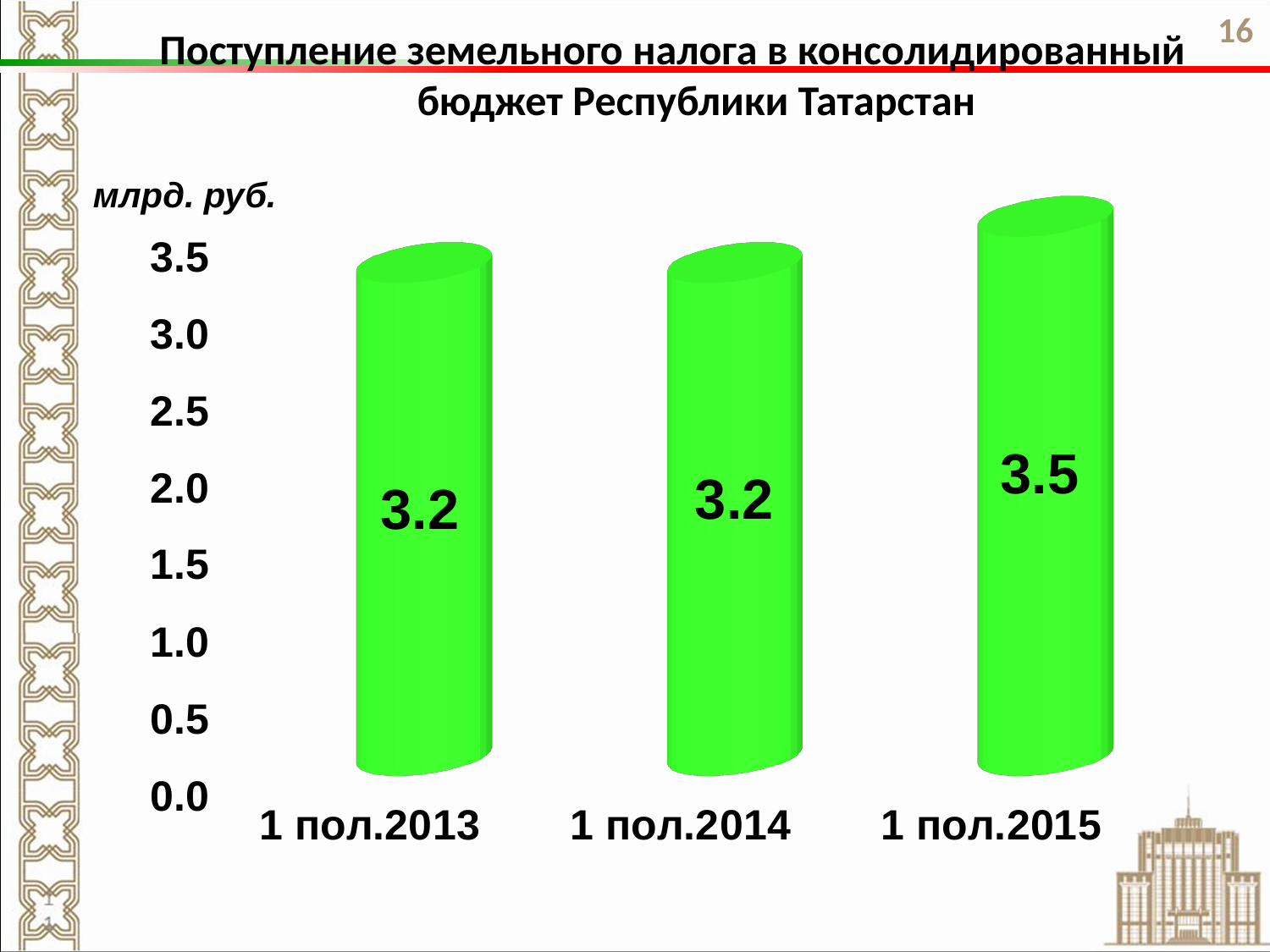
What is the value for 1 пол.2014? 3.2 Is the value for 1 пол.2013 greater or less than 3.0? greater What is the difference between the values for 1 пол.2015 and 1 пол.2014? 0.3 Do the values rise or fall from 1 пол.2014 to 1 пол.2015? rise What colour are the bars on the chart? green What is the value for 1 пол.2015? 3.5 Which is larger, the value for 1 пол.2015 or the value for 1 пол.2013? 1 пол.2015 What kind of chart is shown on the slide? bar chart Which period has the highest value? 1 пол.2015 What unit is shown for the values on the chart? млрд. руб. What is the value for 1 пол.2013? 3.2 How many periods are shown on the chart? 3